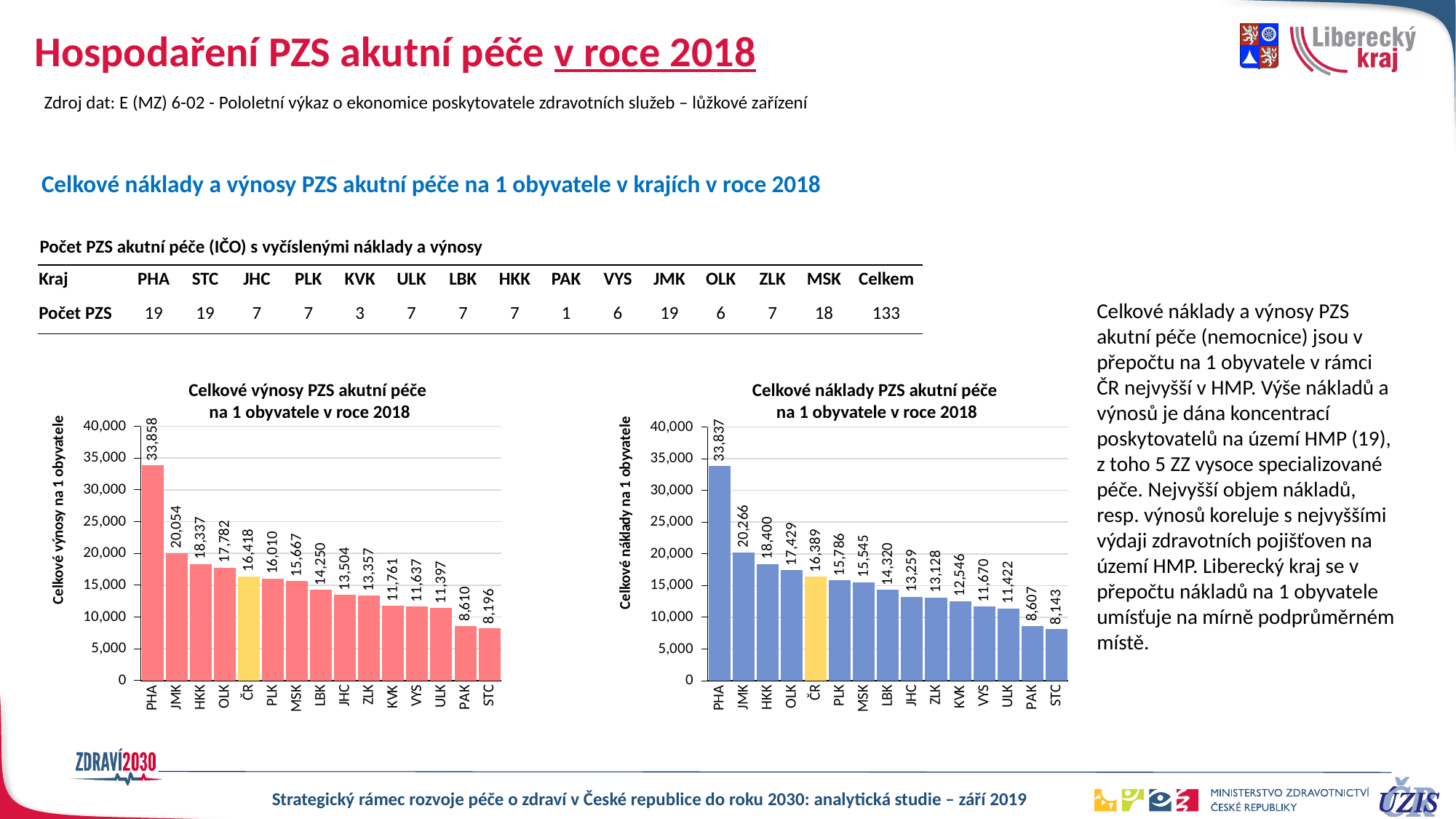
In the chart 'Celkové výnosy PZS akutní péče na 1 obyvatele v roce 2018', what is the difference between the values for PHA and JMK? 13,804 In the chart 'Celkové výnosy PZS akutní péče na 1 obyvatele v roce 2018', which is larger, the value for HKK or the value for OLK? HKK In the chart 'Celkové náklady PZS akutní péče na 1 obyvatele v roce 2018', which bar is highlighted in a different colour (yellow) from the others? ČR In the chart 'Celkové výnosy PZS akutní péče na 1 obyvatele v roce 2018', what is the value for LBK? 14,250 In the chart 'Celkové náklady PZS akutní péče na 1 obyvatele v roce 2018', is the value for KVK greater or less than 10,000? greater In the chart 'Celkové náklady PZS akutní péče na 1 obyvatele v roce 2018', which region has the lowest value? STC In the chart 'Celkové náklady PZS akutní péče na 1 obyvatele v roce 2018', what is the difference between the values for ČR and LBK? 2,069 In the chart 'Celkové náklady PZS akutní péče na 1 obyvatele v roce 2018', what is the value for LBK? 14,320 In the chart 'Celkové výnosy PZS akutní péče na 1 obyvatele v roce 2018', do the values rise or fall from left to right along the x axis? fall How many bars are shown in the chart 'Celkové výnosy PZS akutní péče na 1 obyvatele v roce 2018'? 15 In the chart 'Celkové výnosy PZS akutní péče na 1 obyvatele v roce 2018', which region has the highest value? PHA What type of chart is 'Celkové náklady PZS akutní péče na 1 obyvatele v roce 2018'? bar chart